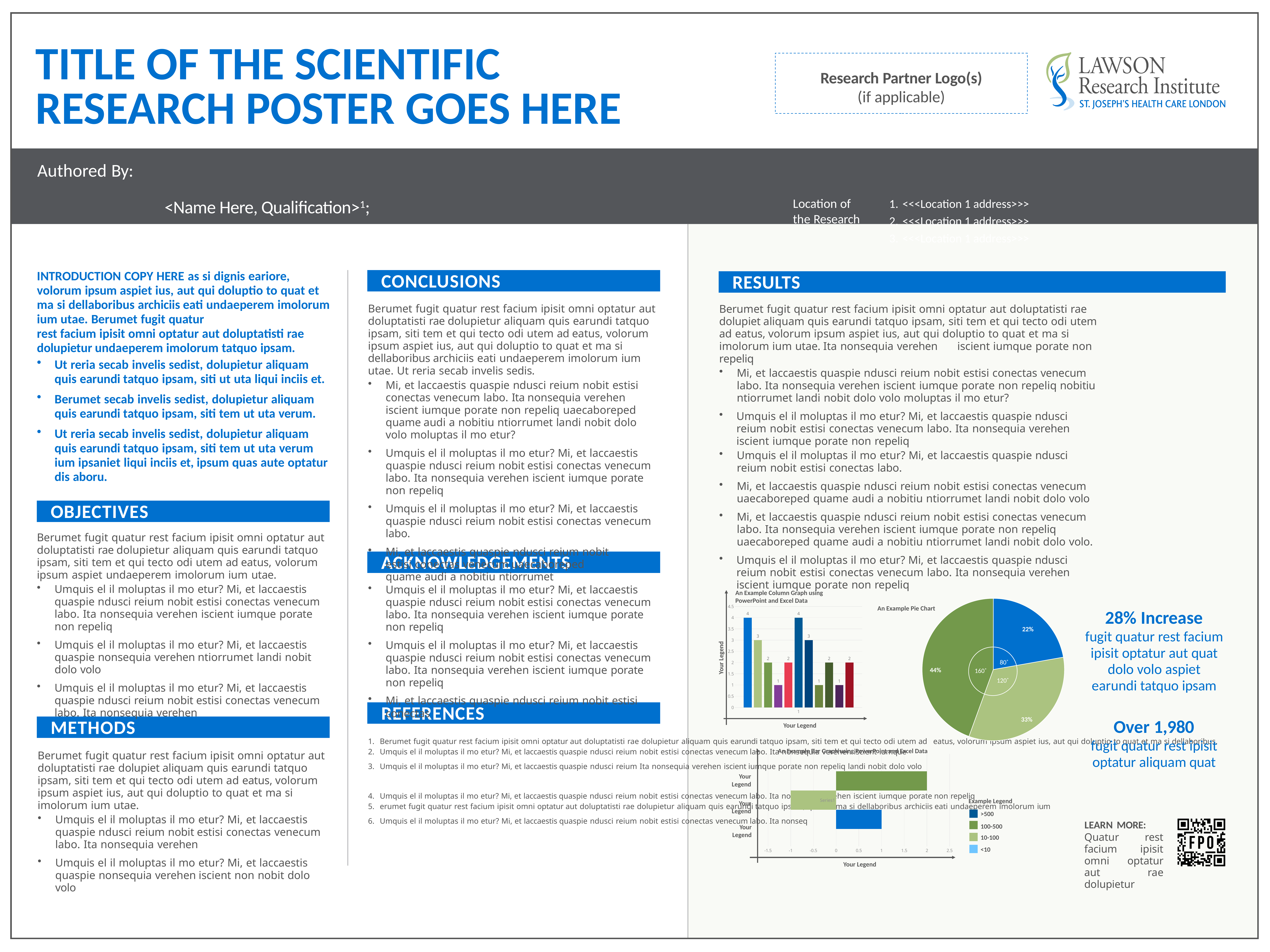
In the chart titled 'An Example Pie Chart', what percentage is shown for the blue slice? 22% In the chart titled 'An Example Column Graph using PowerPoint and Excel Data', what is the highest data label shown on any bar? 4 In the chart titled 'An Example Bar Graph using PowerPoint and Excel Data', is the value of the top (dark green) bar greater or less than 1.5? greater In the chart titled 'An Example Pie Chart', which is larger, the 33% slice or the 22% slice? 33% In the chart titled 'An Example Pie Chart', which slice has the largest share? 44% In the chart titled 'An Example Bar Graph using PowerPoint and Excel Data', how many entries does the 'Example Legend' list? 4 In the chart titled 'An Example Pie Chart', how many slices does the pie have? 3 In the chart titled 'An Example Column Graph using PowerPoint and Excel Data', what is the lowest data label shown on any bar? 1 What kind of chart is 'An Example Pie Chart'? pie chart What kind of chart is 'An Example Column Graph using PowerPoint and Excel Data'? bar chart In the chart titled 'An Example Pie Chart', what is the smallest percentage shown? 22% In the chart titled 'An Example Pie Chart', what is the difference in percentage points between the largest slice (44%) and the smallest slice (22%)? 22